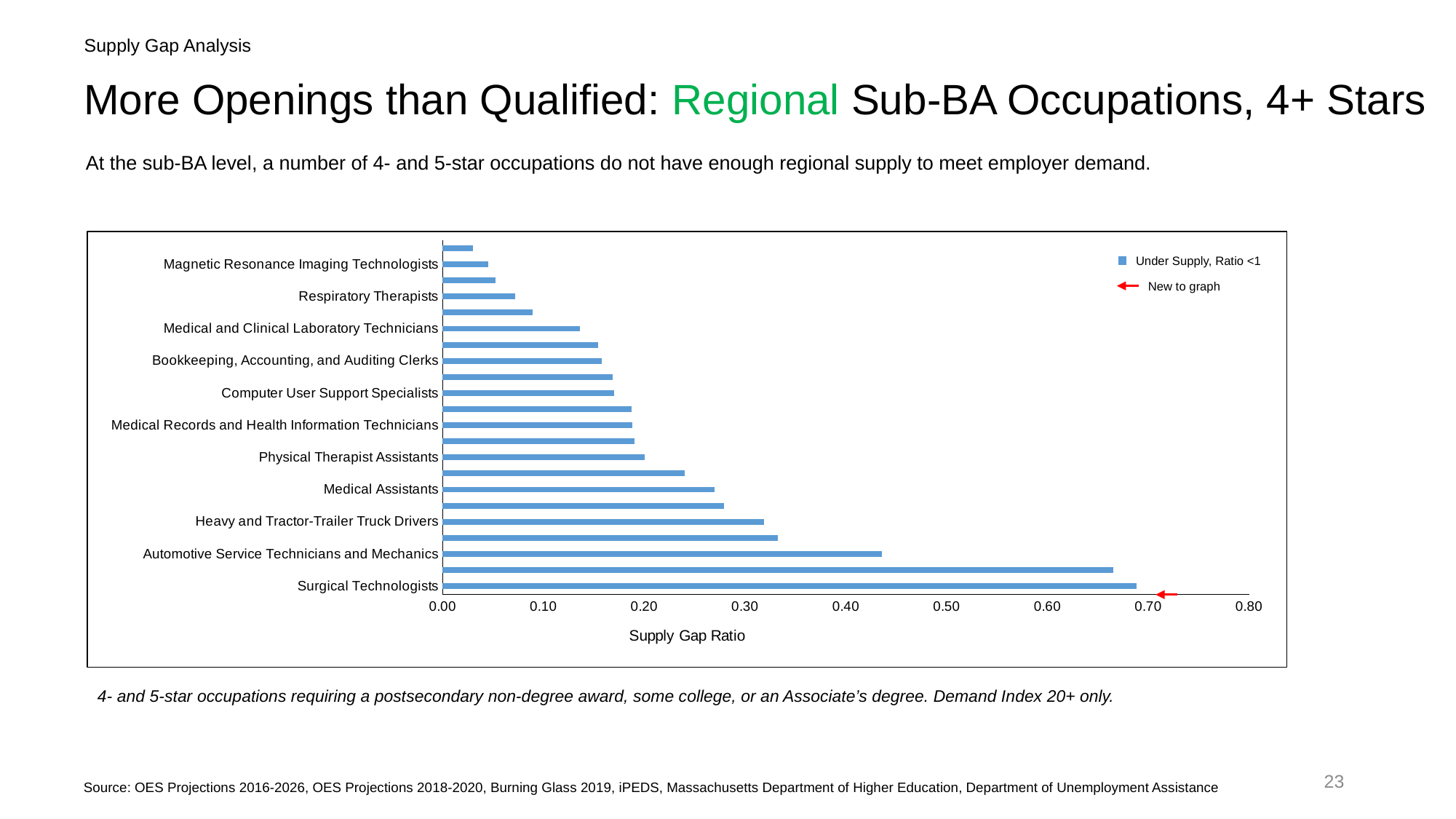
Is the supply gap ratio for Automotive Service Technicians and Mechanics greater or less than 0.40? greater Is the supply gap ratio for Computer User Support Specialists greater or less than 0.20? less Which labeled occupation has the highest supply gap ratio? Surgical Technologists Which has a larger supply gap ratio, Surgical Technologists or Automotive Service Technicians and Mechanics? Surgical Technologists Is the supply gap ratio for Surgical Technologists greater or less than 0.60? greater Which occupation is marked with the red arrow as new to the graph? Surgical Technologists Among the labeled occupations, which has the lowest supply gap ratio? Magnetic Resonance Imaging Technologists What is the title of the x axis of the chart? Supply Gap Ratio What kind of chart is shown on the slide? bar chart Which has a larger supply gap ratio, Heavy and Tractor-Trailer Truck Drivers or Physical Therapist Assistants? Heavy and Tractor-Trailer Truck Drivers